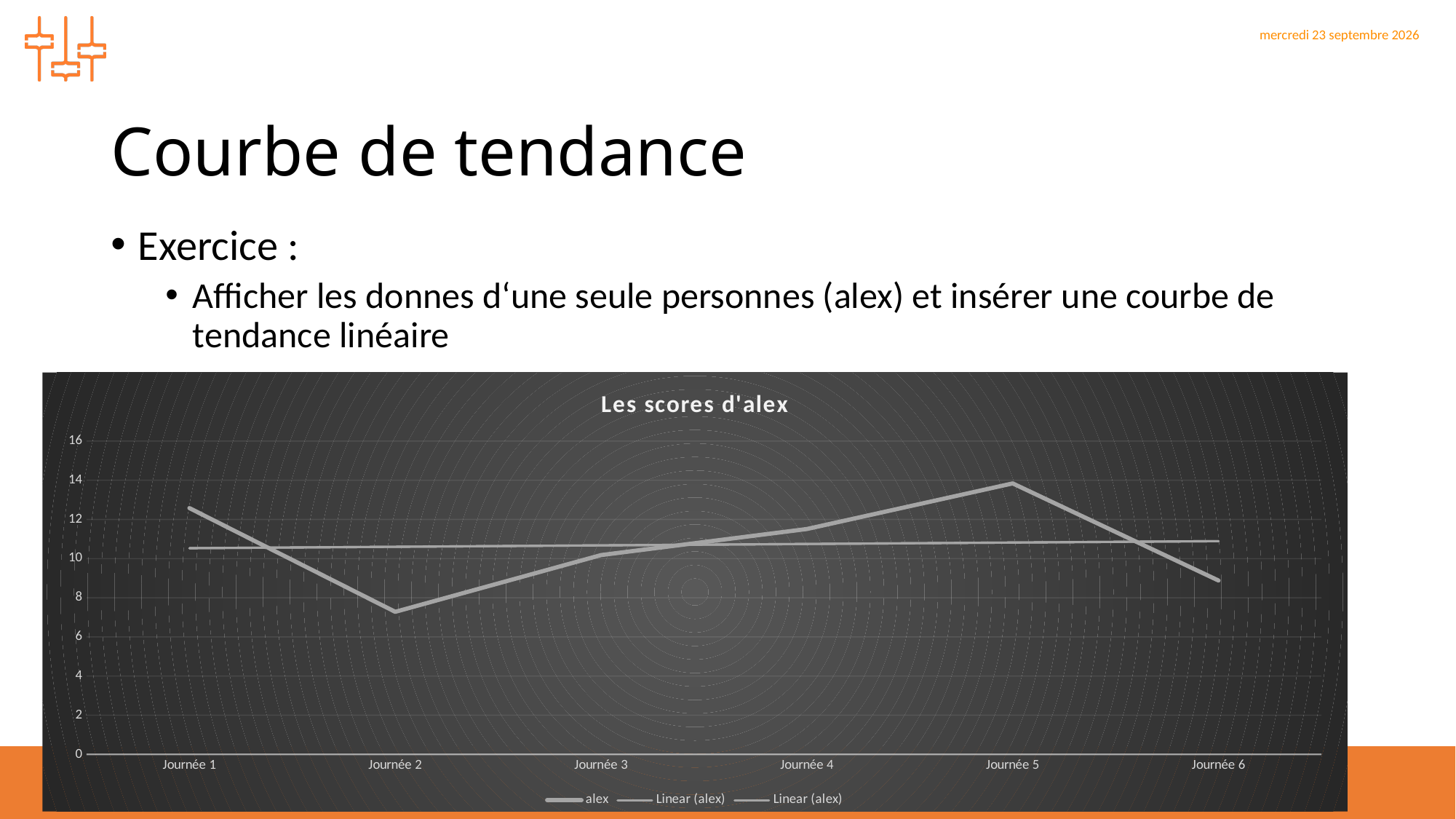
Which is larger, alex's score for Journée 1 or for Journée 2? Journée 1 Is alex's score for Journée 2 greater or less than 8? less Which is larger, alex's score for Journée 5 or for Journée 6? Journée 5 How many categories (journées) are shown on the x axis? 6 On which journée is alex's score the lowest? Journée 2 Is alex's score for Journée 6 greater or less than 10? less Is alex's score for Journée 5 greater or less than 12? greater What kind of chart is shown on the slide? line chart What is the title of the chart? Les scores d'alex On which journée is alex's score the highest? Journée 5 How many entries does the chart legend list? 3 Does alex's score rise or fall from Journée 2 to Journée 5? rise